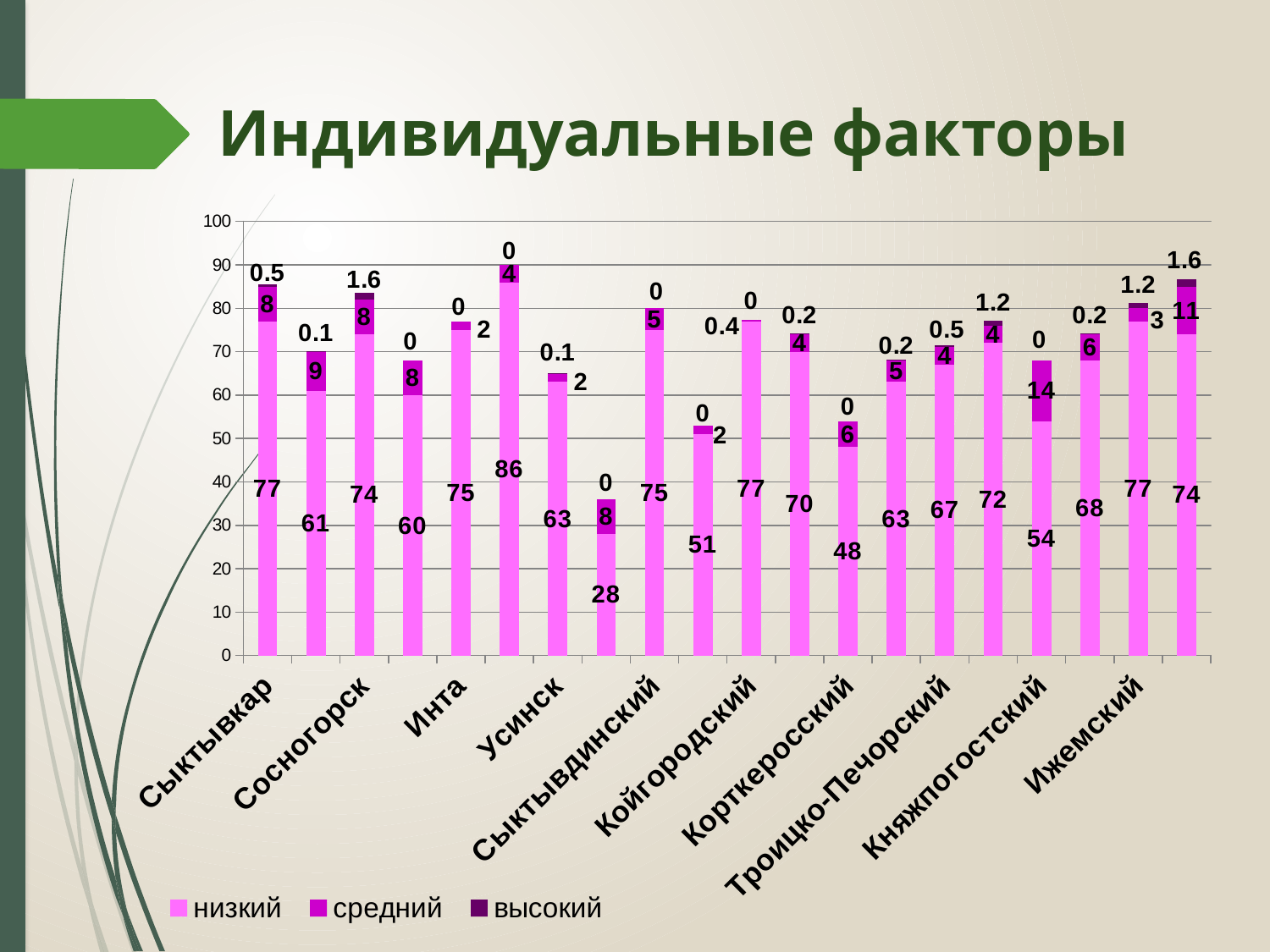
What is the средний value for Княжпогостский? 14 What is the низкий value for Сыктывкар? 77 What are the three series named in the legend? низкий, средний, высокий What is the total of the stacked bar for Сыктывкар? 85.5 What is the lowest низкий value shown in the chart? 28 What is the высокий value for Сосногорск? 1.6 What kind of chart is shown on the slide? stacked bar chart How many series does the legend list? 3 How many bars are plotted in the chart? 20 What is the highest низкий value shown in the chart? 86 What is the низкий value for Корткеросский? 48 Which has a larger низкий value, Инта or Усинск? Инта